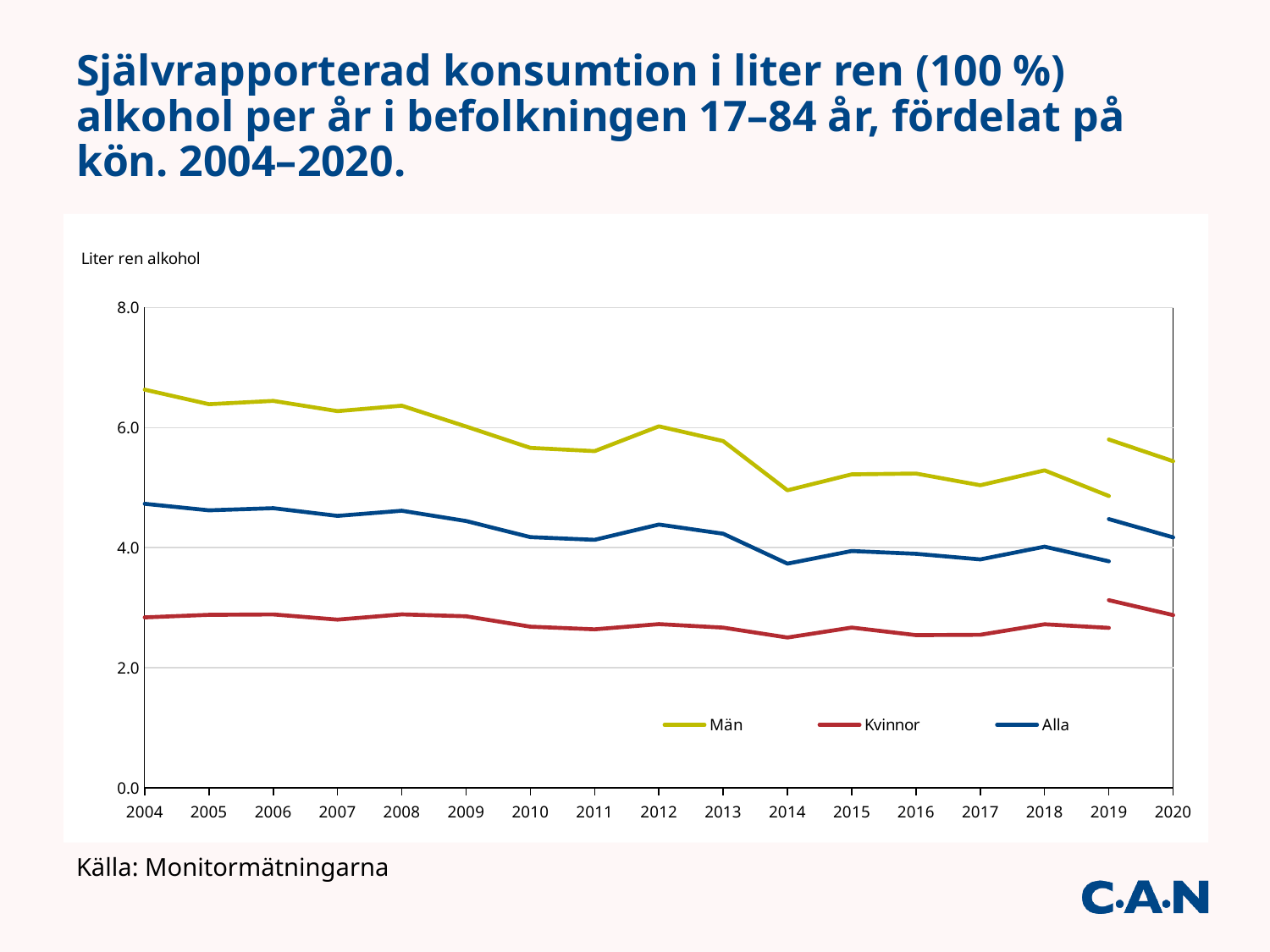
Is the value for Män in 2014 greater or less than 6.0? less Is the value for Alla in 2004 greater or less than 4.0? greater Is the value for Kvinnor in 2004 greater or less than 4.0? less What is the label on the y axis of the chart? Liter ren alkohol In 2010, which is larger: the value for Män or the value for Kvinnor? Män Which series has the highest values throughout the period? Män How many years are plotted along the x axis? 17 How many series does the legend list? 3 What kind of chart is shown on the slide? line chart Does the Män series generally rise or fall from 2004 to 2020? fall